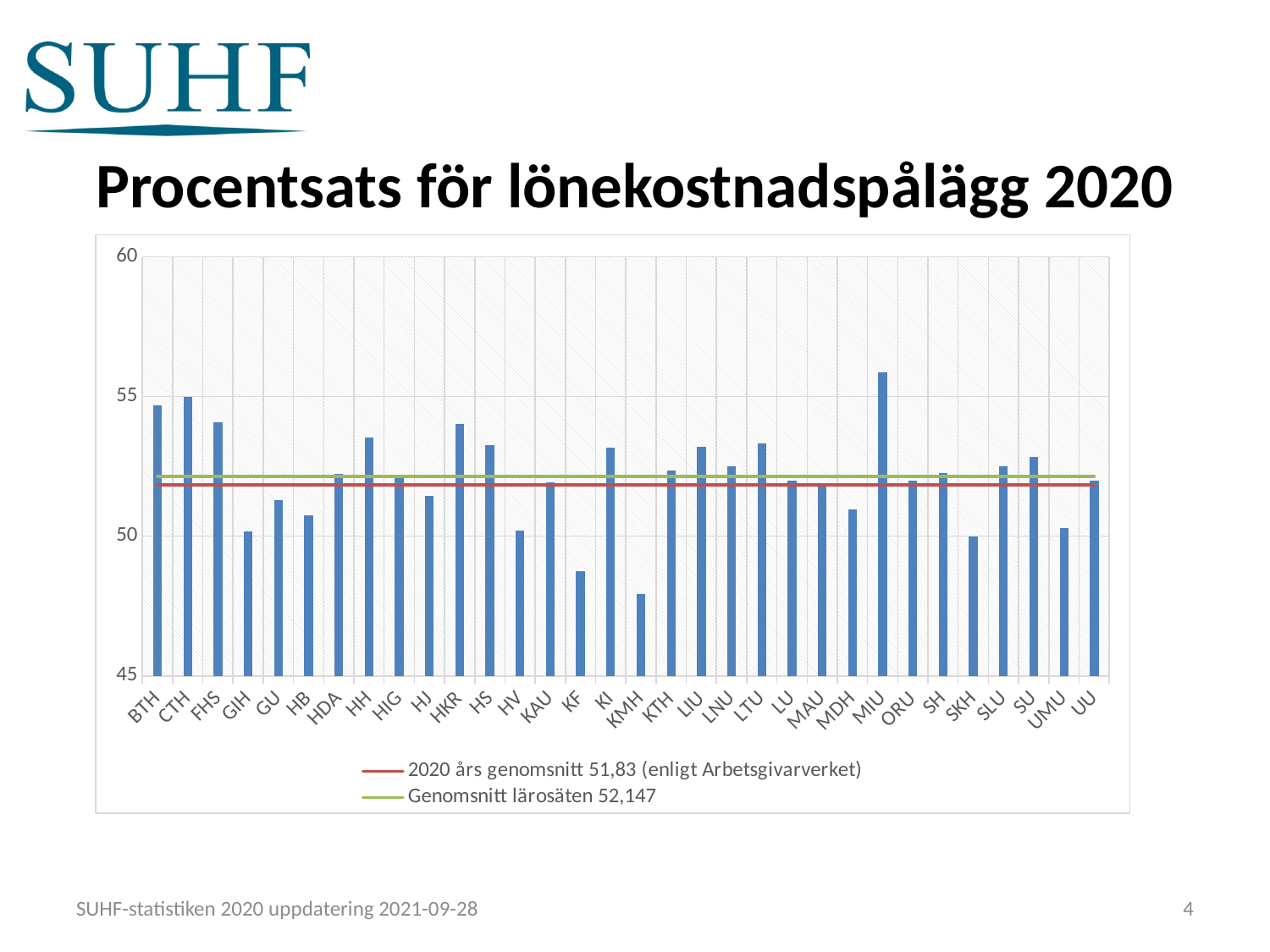
How many categories (institutions) are shown on the x axis of the chart? 32 How many entries does the chart's legend list? 2 Is the value for KF greater or less than 50? less Which institution has the lowest bar in the chart? KMH What kind of chart is shown on the slide? Bar chart Which has the larger value, KMH or HKR? HKR Is the value for MIU greater or less than 55? greater Which has the larger value, CTH or HB? CTH According to the legend, what is the average for the lärosäten (Genomsnitt lärosäten)? 52,147 Which institution has the highest bar in the chart? MIU What is the title of the chart? Procentsats för lönekostnadspålägg 2020 According to the legend, what is the 2020 average according to Arbetsgivarverket? 51,83